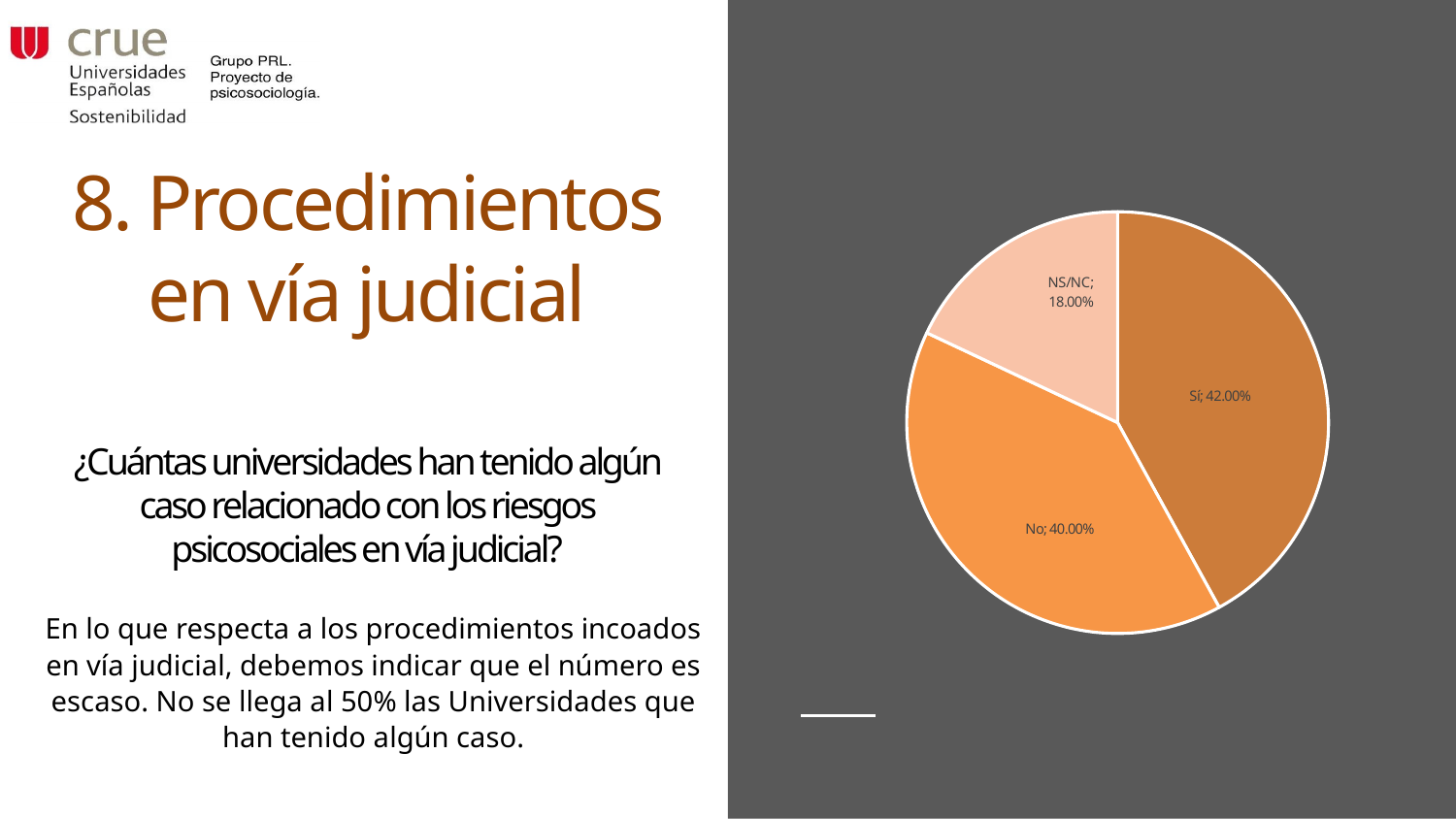
Which slice of the pie chart is the lightest in colour? NS/NC Which is larger, the "No" slice or the "NS/NC" slice? No How many slices does the pie chart have? 3 What is the difference in percentage points between the "No" slice and the "NS/NC" slice? 22.00% What is the difference in percentage points between the "Sí" slice and the "No" slice? 2.00% What percentage of the pie chart is labelled "Sí"? 42.00% Which slice of the pie chart is the smallest? NS/NC What percentage of the pie chart is labelled "No"? 40.00% What is the combined share of the "Sí" and "No" slices? 82.00% What percentage of the pie chart is labelled "NS/NC"? 18.00% What type of chart is shown on the slide? Pie chart Which slice of the pie chart is the largest? Sí